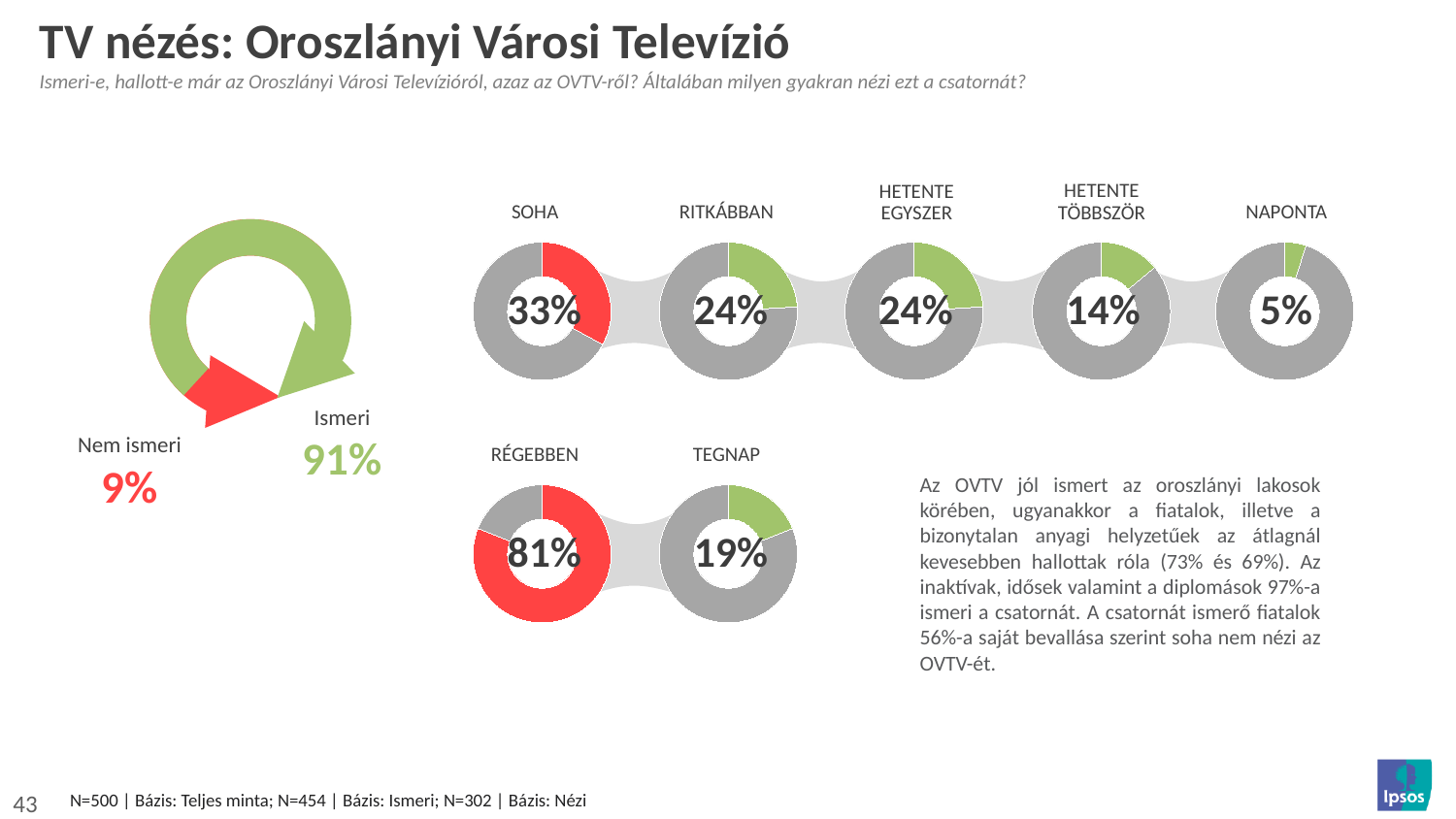
In the row of five small donut charts at the top, what value is shown for SOHA? 33% In the row of five small donut charts at the top, which is larger: the value for RITKÁBBAN or the value for HETENTE TÖBBSZÖR? RITKÁBBAN Among the five small donut charts at the top, which category has the lowest value? NAPONTA In the row of five small donut charts at the top, what is the difference between the SOHA value and the NAPONTA value? 28% In the large donut chart on the left, what percentage is shown for "Ismeri"? 91% In the pair of donut charts at the bottom, what value is shown for TEGNAP? 19% In the row of five small donut charts at the top, what value is shown for HETENTE TÖBBSZÖR? 14% How many small donut charts are in the top row of frequency categories? 5 In the pair of donut charts at the bottom, what value is shown for RÉGEBBEN? 81% In the large donut chart on the left, what percentage is shown for "Nem ismeri"? 9% In the row of five small donut charts at the top, what value is shown for NAPONTA? 5% Among the five small donut charts at the top, which category has the highest value? SOHA